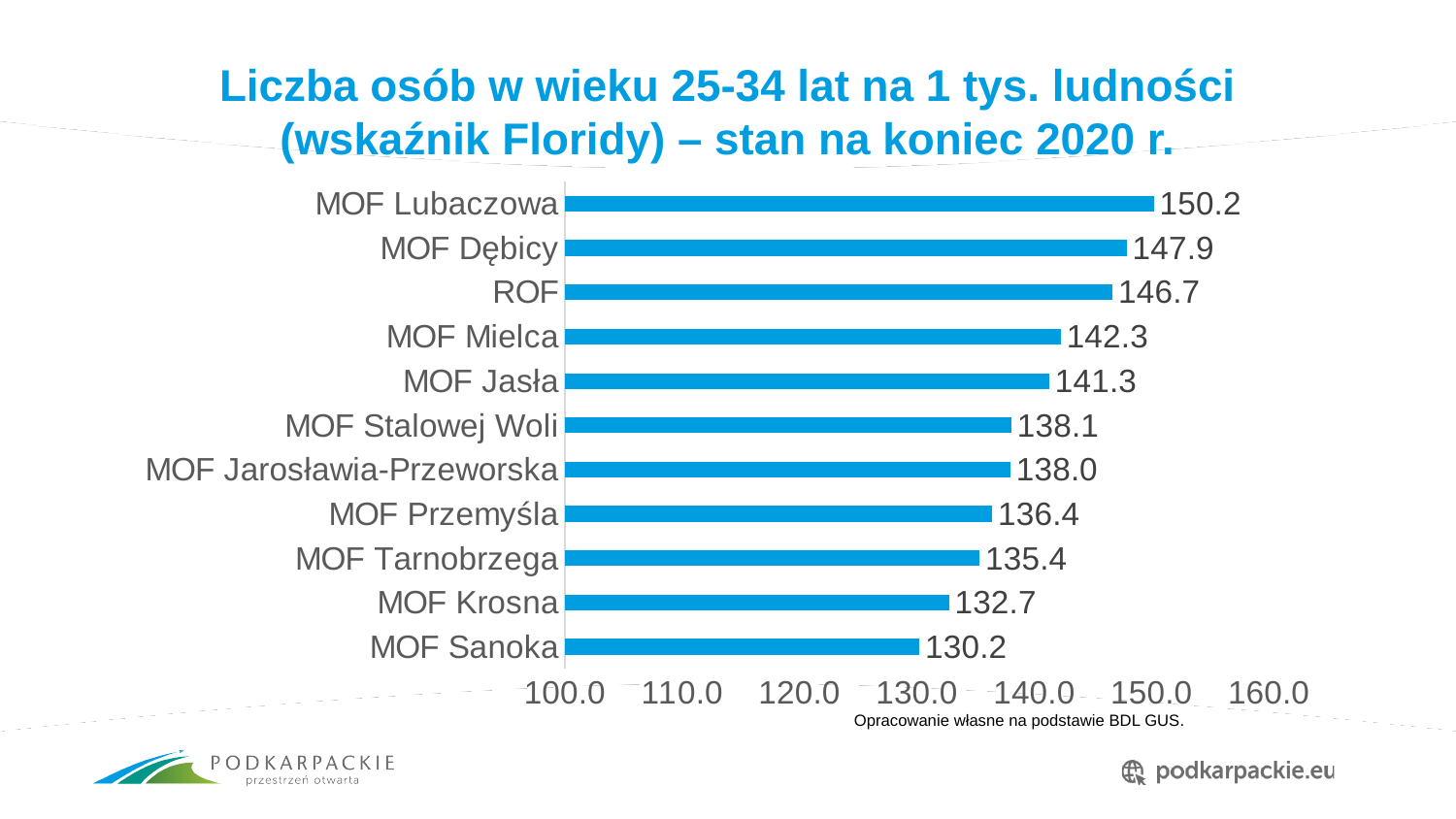
Is the value for MOF Tarnobrzega greater or less than 140.0? less What is the value for ROF? 146.7 What kind of chart is shown on the slide? bar chart How many categories are shown in the chart? 11 What is the title of the chart? Liczba osób w wieku 25-34 lat na 1 tys. ludności (wskaźnik Floridy) – stan na koniec 2020 r. What is the difference between the values for MOF Lubaczowa and MOF Sanoka? 20.0 Which category has the highest value? MOF Lubaczowa What is the difference between the values for MOF Mielca and MOF Jasła? 1.0 Which category has the lowest value? MOF Sanoka What is the value for MOF Krosna? 132.7 What is the value for MOF Lubaczowa? 150.2 Which is larger, the value for MOF Dębicy or the value for MOF Przemyśla? MOF Dębicy